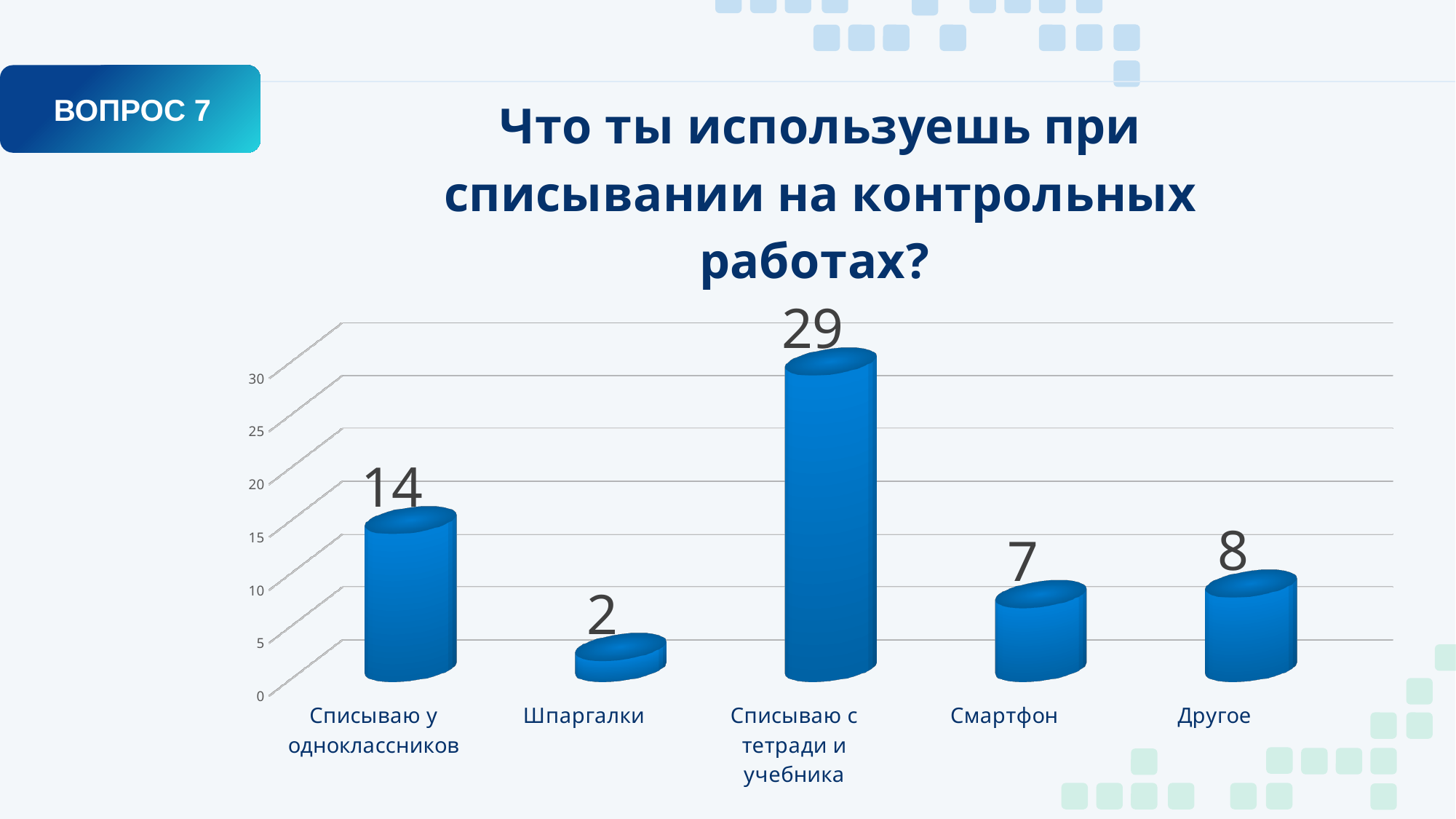
What value is shown for "Шпаргалки"? 2 What value is shown for "Списываю с тетради и учебника"? 29 Is the value for "Списываю у одноклассников" greater or less than 10? greater Which is larger, the value for "Другое" or the value for "Смартфон"? Другое How many categories are shown on the x axis? 5 What value is shown for "Смартфон"? 7 What is the title of the chart? Что ты используешь при списывании на контрольных работах? What is the difference between the values for "Списываю с тетради и учебника" and "Списываю у одноклассников"? 15 What value is shown for "Списываю у одноклассников"? 14 Which category has the lowest value? Шпаргалки Which category has the highest value? Списываю с тетради и учебника What kind of chart is shown on the slide? bar chart